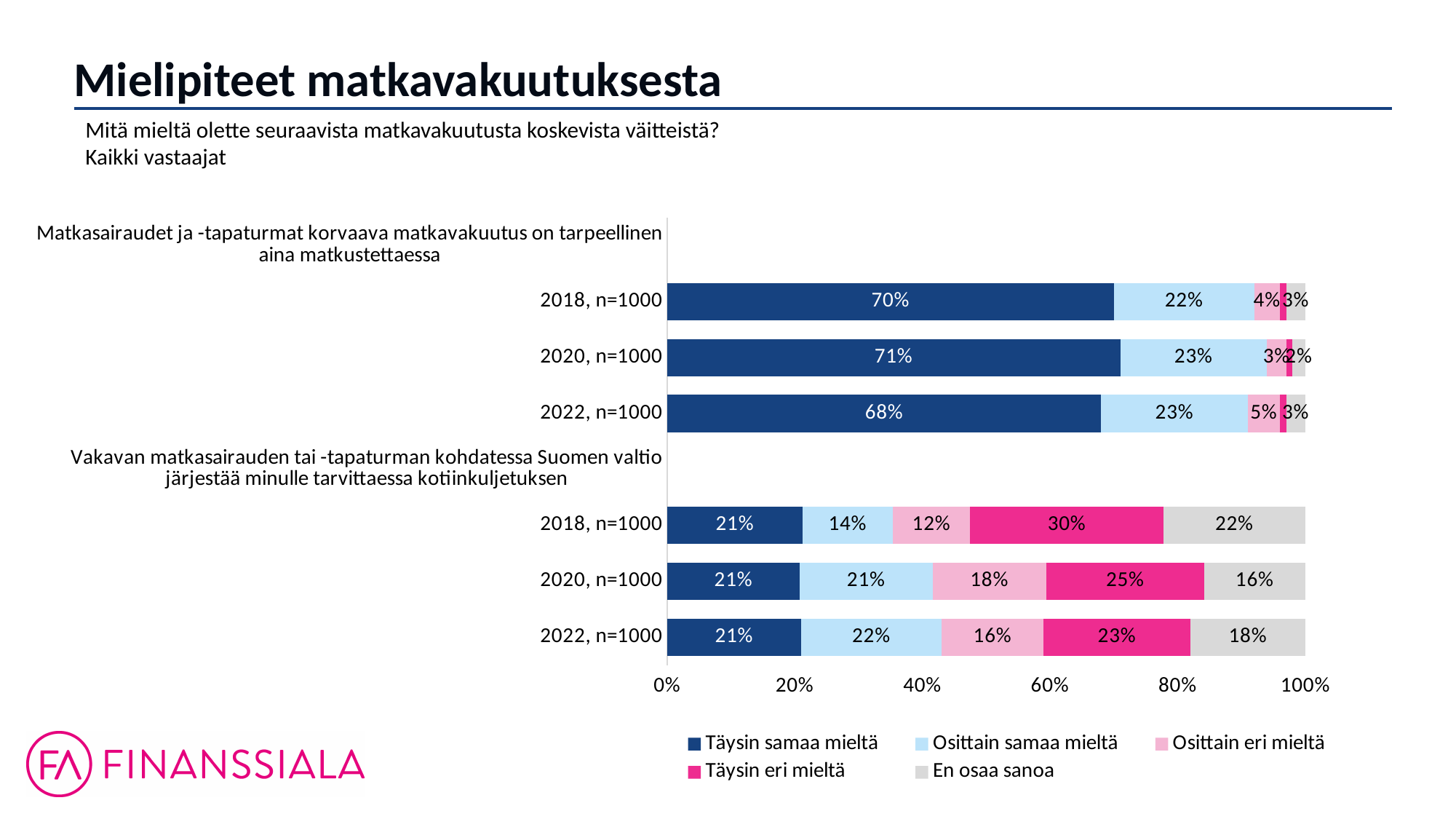
For the statement 'Matkasairaudet ja -tapaturmat korvaava matkavakuutus on tarpeellinen aina matkustettaessa', what is the 'Täysin samaa mieltä' share in 2020, n=1000? 71% For the statement 'Vakavan matkasairauden tai -tapaturman kohdatessa Suomen valtio järjestää minulle tarvittaessa kotiinkuljetuksen', what is the 'Täysin eri mieltä' share in 2018, n=1000? 30% For the statement 'Matkasairaudet ja -tapaturmat korvaava matkavakuutus on tarpeellinen aina matkustettaessa', which is larger: the 'Täysin samaa mieltä' share in 2020 or in 2022? 2020 What kind of chart is shown on the slide? stacked bar chart For the statement 'Matkasairaudet ja -tapaturmat korvaava matkavakuutus on tarpeellinen aina matkustettaessa', what is the 'Osittain samaa mieltä' share in 2022, n=1000? 23% For the statement 'Vakavan matkasairauden tai -tapaturman kohdatessa Suomen valtio järjestää minulle tarvittaessa kotiinkuljetuksen', what is the 'En osaa sanoa' share in 2020, n=1000? 16% For the statement about Suomen valtio arranging kotiinkuljetus, does the 'Osittain samaa mieltä' share rise or fall from 2018 to 2022? rise For the statement about Suomen valtio arranging kotiinkuljetus, which year has the highest 'Täysin eri mieltä' share? 2018, n=1000 For the statement about Suomen valtio arranging kotiinkuljetus, which year has the lowest 'Osittain samaa mieltä' share? 2018, n=1000 How many series does the legend list? 5 How many bars (year rows) are plotted in the chart in total? 6 For the statement about Suomen valtio arranging kotiinkuljetus, what is the difference between the 'Täysin eri mieltä' shares in 2018 and 2022? 7%